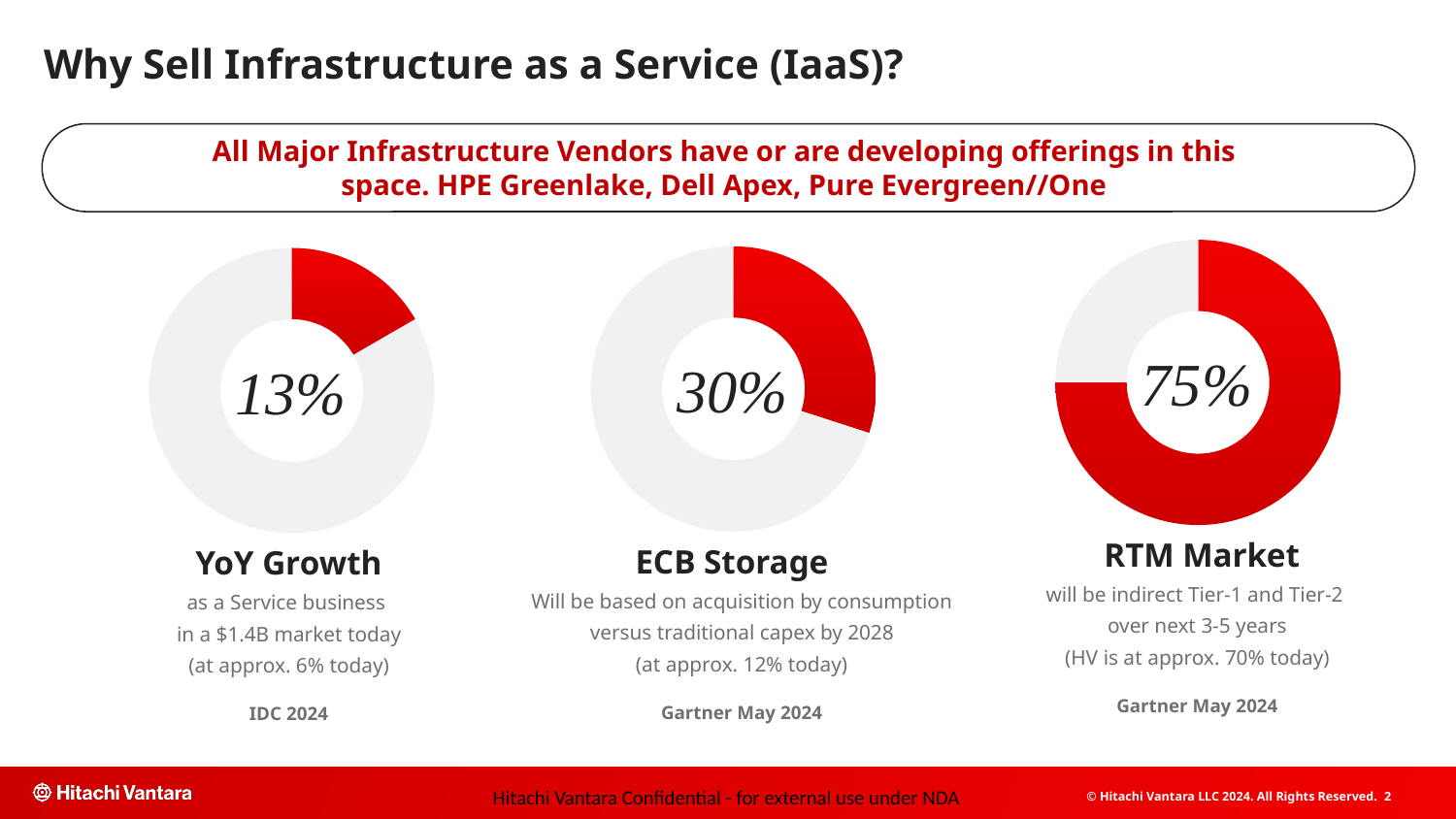
What value is shown in the centre of the ECB Storage donut chart? 30% What source is cited beneath the YoY Growth donut chart? IDC 2024 What is the difference between the ECB Storage percentage and the YoY Growth percentage? 17% What kind of chart is used to show the YoY Growth value? Donut chart What value is shown in the centre of the RTM Market donut chart? 75% How many donut charts are shown on the slide? 3 What is the difference between the RTM Market percentage and the ECB Storage percentage? 45% What colour is the filled portion of each donut chart? Red Which of the three donut charts shows the lowest percentage? YoY Growth Which of the three donut charts shows the highest percentage? RTM Market What value is shown in the centre of the YoY Growth donut chart? 13% Which is larger, the ECB Storage percentage or the YoY Growth percentage? ECB Storage